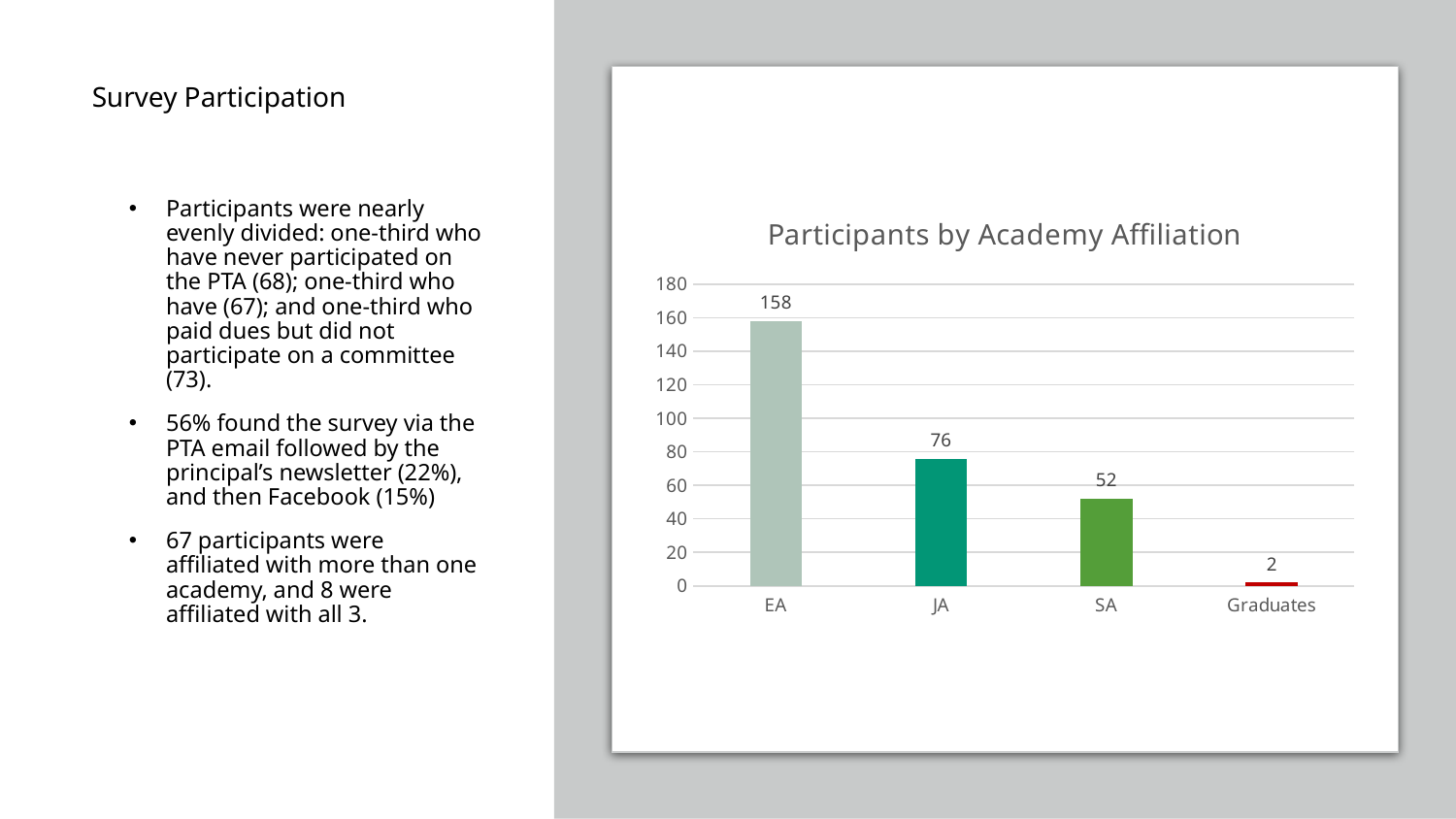
Do the values rise or fall from left to right along the x axis in the Participants by Academy Affiliation chart? fall What is the difference between the values for EA and JA in the Participants by Academy Affiliation chart? 82 How many categories are shown in the Participants by Academy Affiliation chart? 4 Which category has the highest value in the Participants by Academy Affiliation chart? EA What is the value for JA in the Participants by Academy Affiliation chart? 76 Which is larger in the Participants by Academy Affiliation chart, JA or SA? JA Which category has the lowest value in the Participants by Academy Affiliation chart? Graduates Is the value for EA greater or less than 140 in the Participants by Academy Affiliation chart? greater What kind of chart is the Participants by Academy Affiliation chart? bar chart What is the value for SA in the Participants by Academy Affiliation chart? 52 What is the value for Graduates in the Participants by Academy Affiliation chart? 2 What is the value for EA in the Participants by Academy Affiliation chart? 158